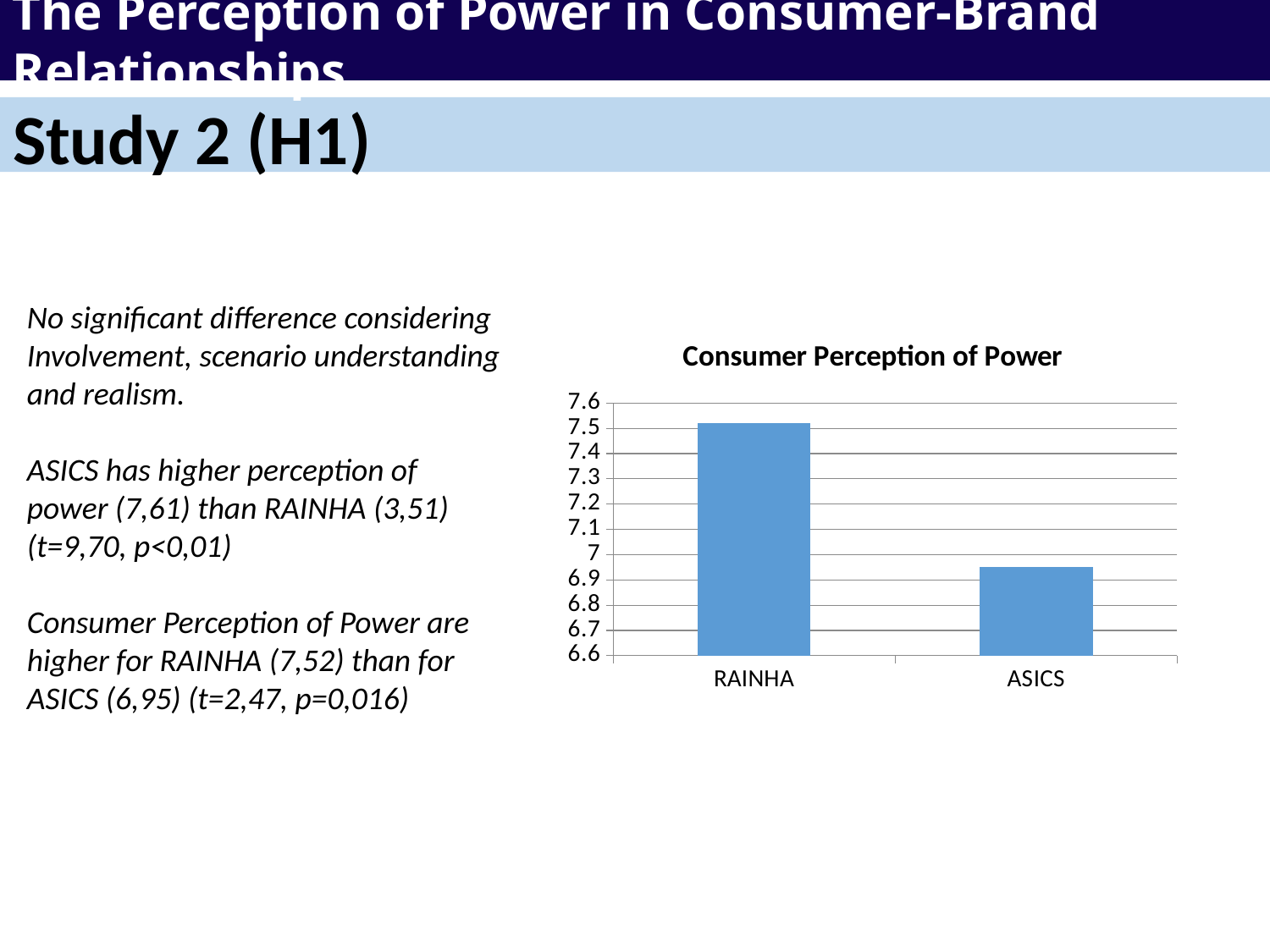
Which bar is taller, RAINHA or ASICS? RAINHA How many categories are shown on the x axis of the chart? 2 What is the title of the chart? Consumer Perception of Power Is the value for RAINHA greater or less than 7.4? greater Is the value for RAINHA greater or less than 7.6? less Which category has the lowest bar in the chart? ASICS Is the value for ASICS greater or less than 7? less What kind of chart is shown on the slide? bar chart Which category has the highest bar in the chart? RAINHA What is the lowest value shown on the y axis of the chart? 6.6